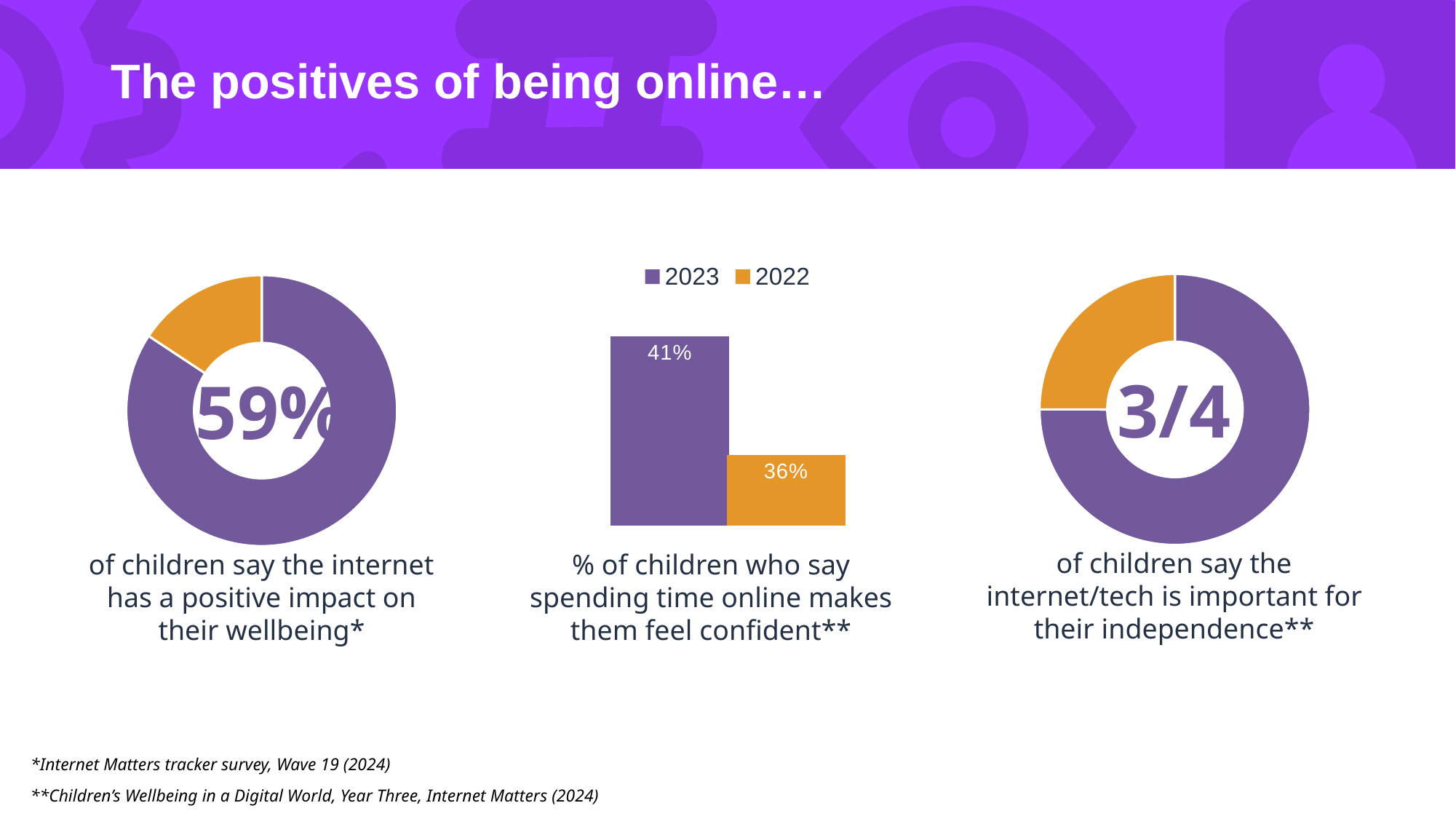
In the middle bar chart, which year has the higher value? 2023 In the middle bar chart, what is the value for 2022? 36% What kind of chart is the middle chart on the slide? bar chart How many bars are plotted in the middle bar chart? 2 In the middle bar chart, which colour represents 2022 according to the legend? orange In the middle bar chart, what is the difference between the 2023 and 2022 values? 5% In the middle bar chart, which year has the lower value? 2022 In the middle bar chart, what is the value for 2023? 41% How many series does the legend of the middle chart list? 2 In the middle bar chart, is the value for 2022 larger or smaller than the value for 2023? smaller What figure is displayed in the centre of the right donut chart? 3/4 What figure is displayed in the centre of the left donut chart? 59%